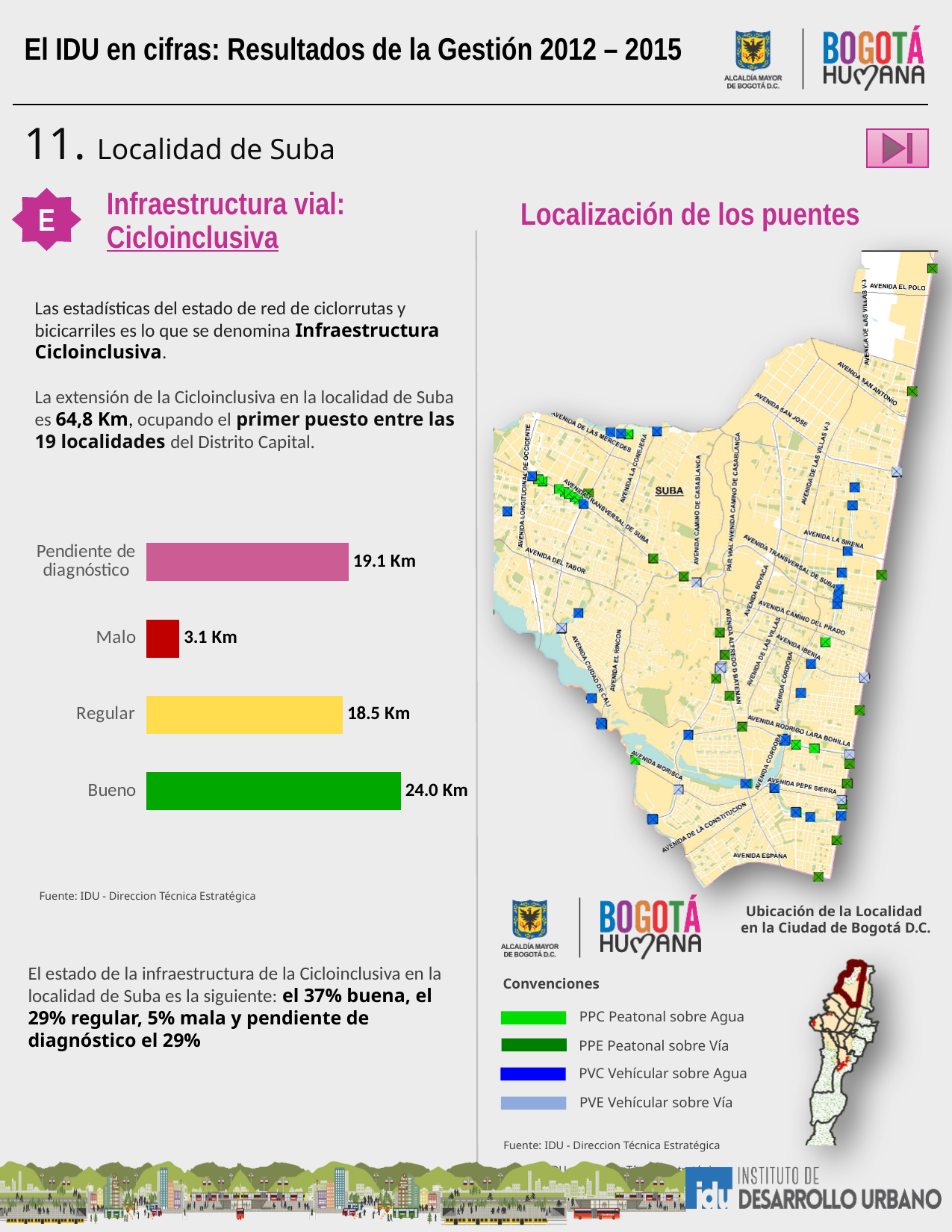
What kind of chart is shown on the left of the slide? Bar chart What is the value for Bueno in the bar chart? 24.0 Km What is the value for Pendiente de diagnóstico in the bar chart? 19.1 Km What is the value for Malo in the bar chart? 3.1 Km Which category has the highest value in the bar chart? Bueno Which is larger in the bar chart, the value for Regular or the value for Malo? Regular How many categories are shown in the bar chart? 4 What is the value for Regular in the bar chart? 18.5 Km What is the difference between the values for Bueno and Malo in the bar chart? 20.9 Km Which category has the lowest value in the bar chart? Malo What is the difference between the values for Pendiente de diagnóstico and Regular in the bar chart? 0.6 Km What colour is the bar for Malo in the bar chart? Red